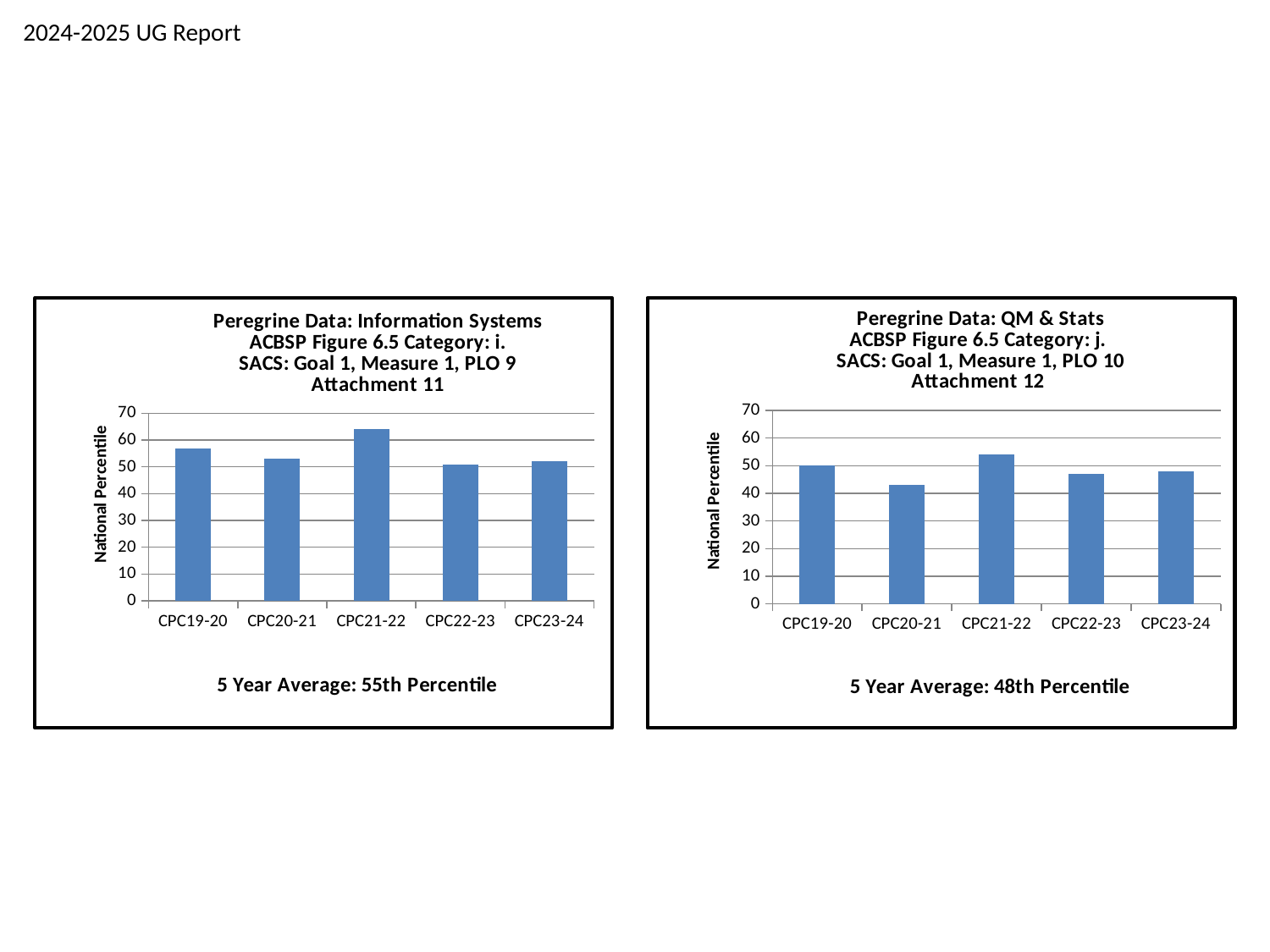
In the Peregrine Data: QM & Stats chart, is the value for CPC20-21 greater or less than 50? less In the Peregrine Data: Information Systems chart, is the value for CPC19-20 greater or less than 50? greater In the Peregrine Data: Information Systems chart, which is larger, the value for CPC19-20 or CPC20-21? CPC19-20 In the Peregrine Data: Information Systems chart, is the value for CPC21-22 greater or less than 60? greater In the Peregrine Data: QM & Stats chart, which category has the highest bar? CPC21-22 In the Peregrine Data: QM & Stats chart, which is larger, the value for CPC21-22 or CPC22-23? CPC21-22 In the Peregrine Data: QM & Stats chart, which category has the lowest bar? CPC20-21 What is the y-axis label of the Peregrine Data: Information Systems chart? National Percentile In the Peregrine Data: Information Systems chart, which category has the highest bar? CPC21-22 What kind of chart is the Peregrine Data: QM & Stats chart? bar chart How many categories are shown on the x axis of the Peregrine Data: Information Systems chart? 5